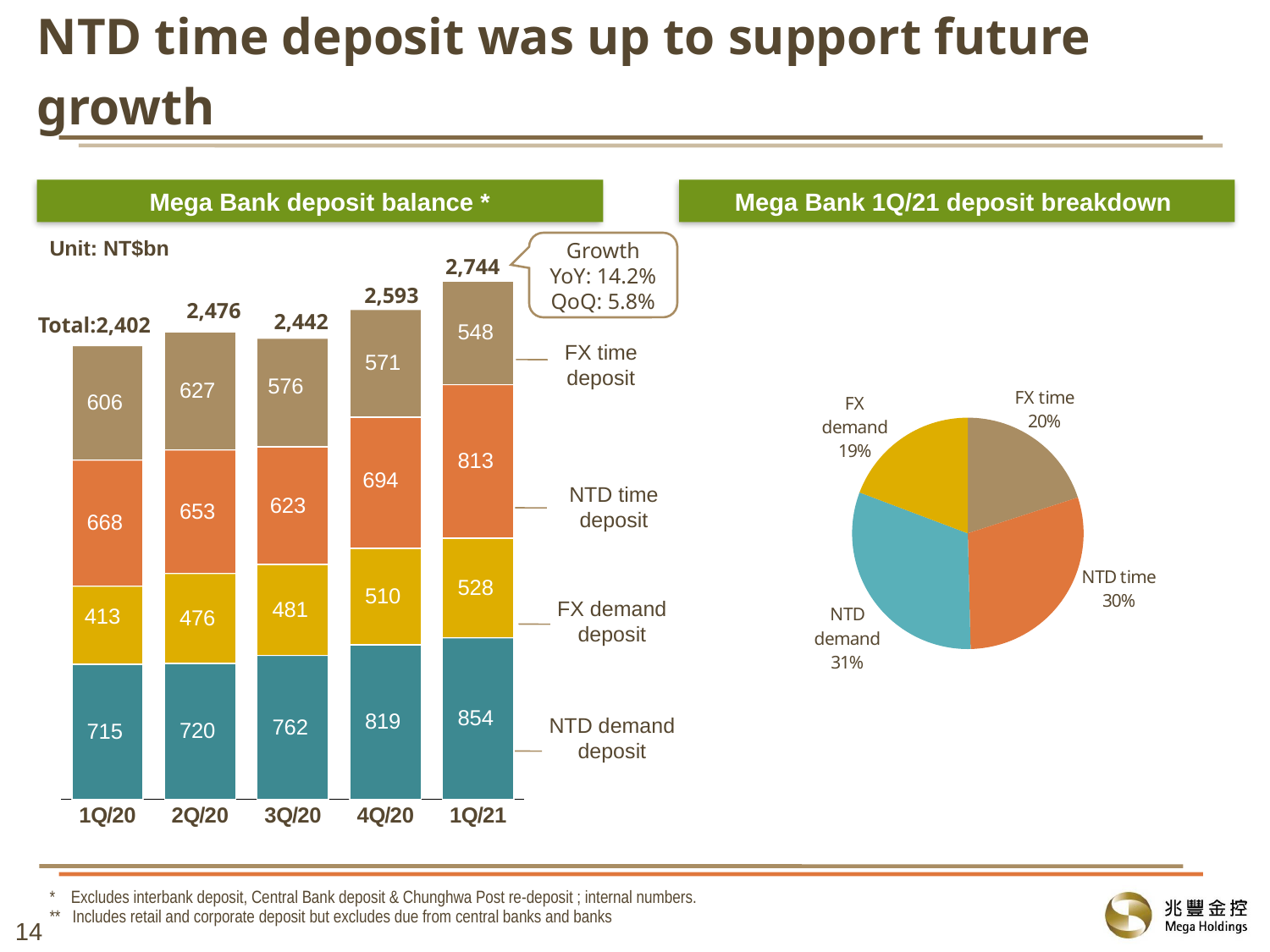
What kind of chart is the 'Mega Bank deposit balance' chart? Stacked bar chart In the 'Mega Bank 1Q/21 deposit breakdown' pie chart, which slice is the smallest? FX demand In the 'Mega Bank deposit balance' chart, what is the total deposit balance for 2Q/20? 2,476 In the 'Mega Bank deposit balance' chart, what is the difference between the NTD time deposit values for 1Q/21 and 4Q/20? 119 In the 'Mega Bank deposit balance' chart, what is the FX time deposit value for 4Q/20? 571 In the 'Mega Bank deposit balance' chart, which is larger: the FX demand deposit for 3Q/20 or for 2Q/20? 3Q/20 How many quarters are shown in the 'Mega Bank deposit balance' chart? 5 In the 'Mega Bank deposit balance' chart, does the NTD demand deposit rise or fall from 1Q/20 to 1Q/21? Rise In the 'Mega Bank deposit balance' chart, which quarter has the highest total deposit balance? 1Q/21 In the 'Mega Bank deposit balance' chart, which quarter has the lowest total deposit balance? 1Q/20 In the 'Mega Bank deposit balance' chart, what is the NTD demand deposit value for 1Q/21? 854 In the 'Mega Bank 1Q/21 deposit breakdown' pie chart, what share is NTD demand? 31%